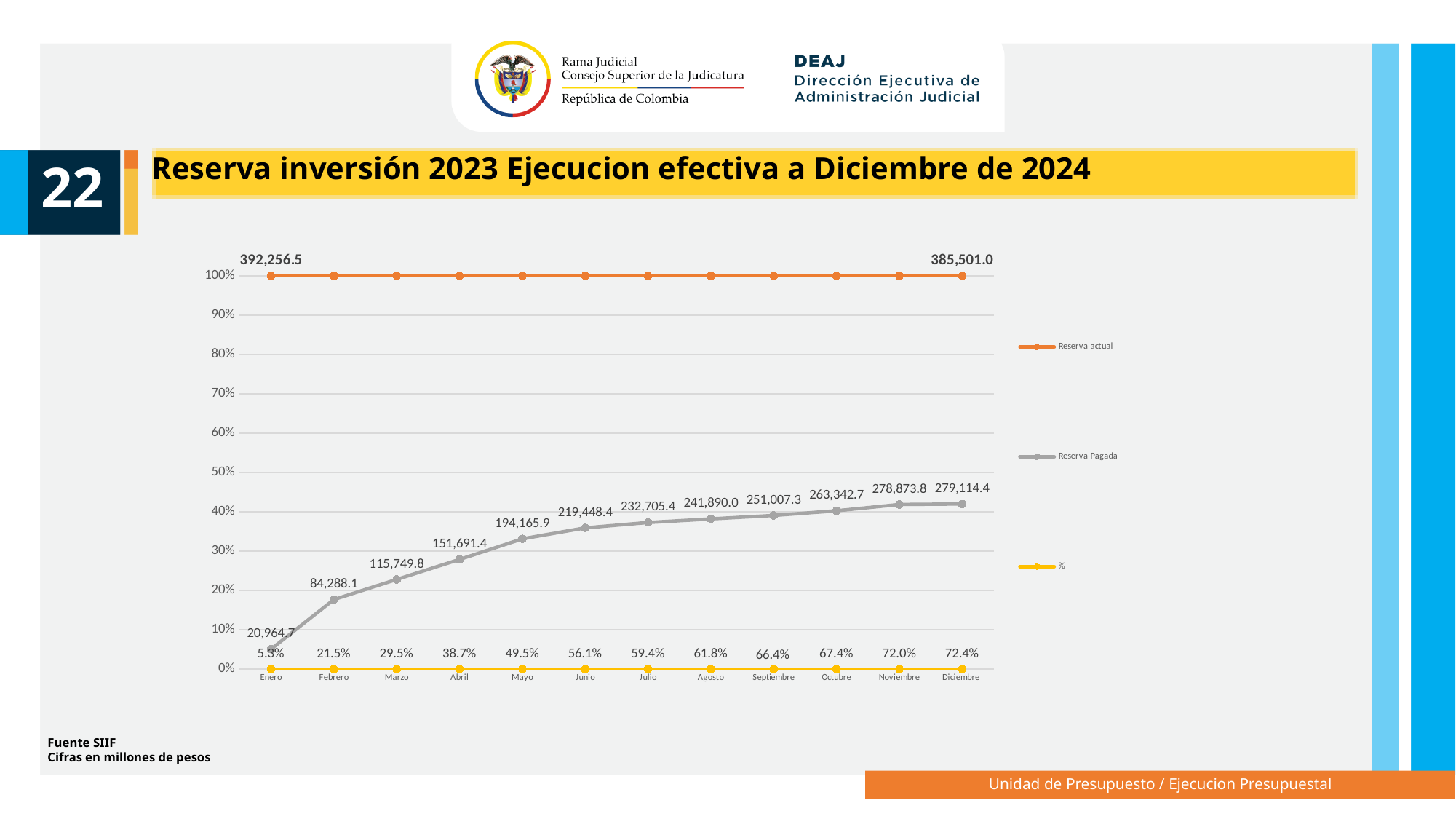
In which month is the Reserva Pagada value lowest? Enero In which month is the % value highest? Diciembre How many months are plotted along the x axis? 12 What is the Reserva actual value labelled for Diciembre? 385,501.0 What is the % value for Septiembre? 66.4% How many series does the legend list? 3 What is the Reserva Pagada value for Marzo? 115,749.8 Does the Reserva Pagada series rise or fall from Enero to Diciembre? rise What is the difference between the Reserva Pagada values for Diciembre and Noviembre? 240.6 What is the Reserva actual value labelled for Enero? 392,256.5 What type of chart is shown on the slide? line chart Which is larger, the Reserva Pagada value for Junio or for Abril? Junio